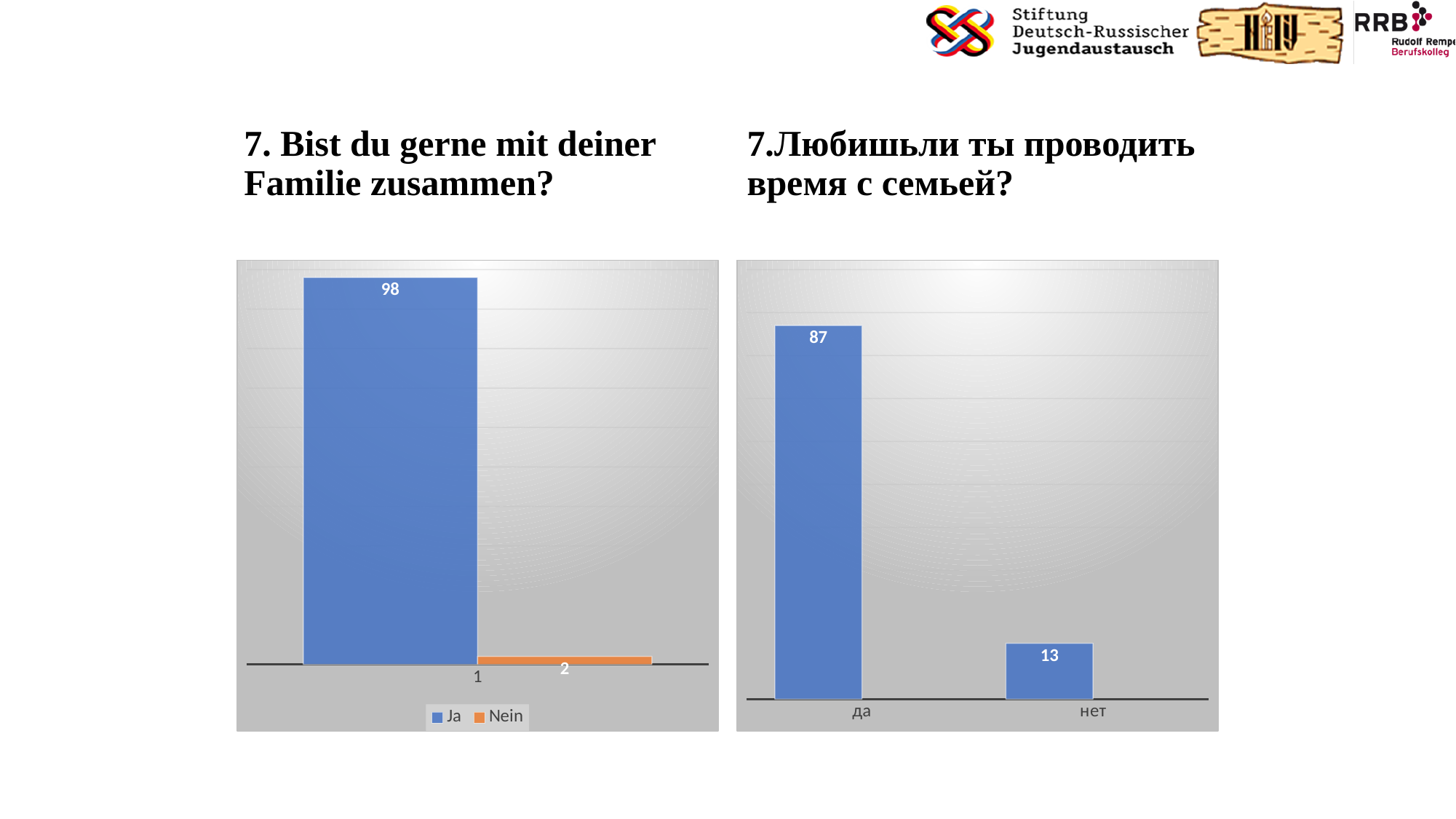
In the right chart, what is the difference between the да and нет values? 74 In the left chart, what is the value for Nein? 2 What kind of chart is the right chart? bar chart In the right chart, which category has the highest value? да How many categories are shown on the x axis of the right chart? 2 In the left chart, what is the value for Ja? 98 In the right chart, what is the value for нет? 13 How many series does the legend of the left chart list? 2 In the left chart, which series has the lowest value? Nein In the right chart, is the value for да larger or smaller than the value for нет? larger In the right chart, what is the value for да? 87 In the left chart, what is the difference between the Ja and Nein values? 96